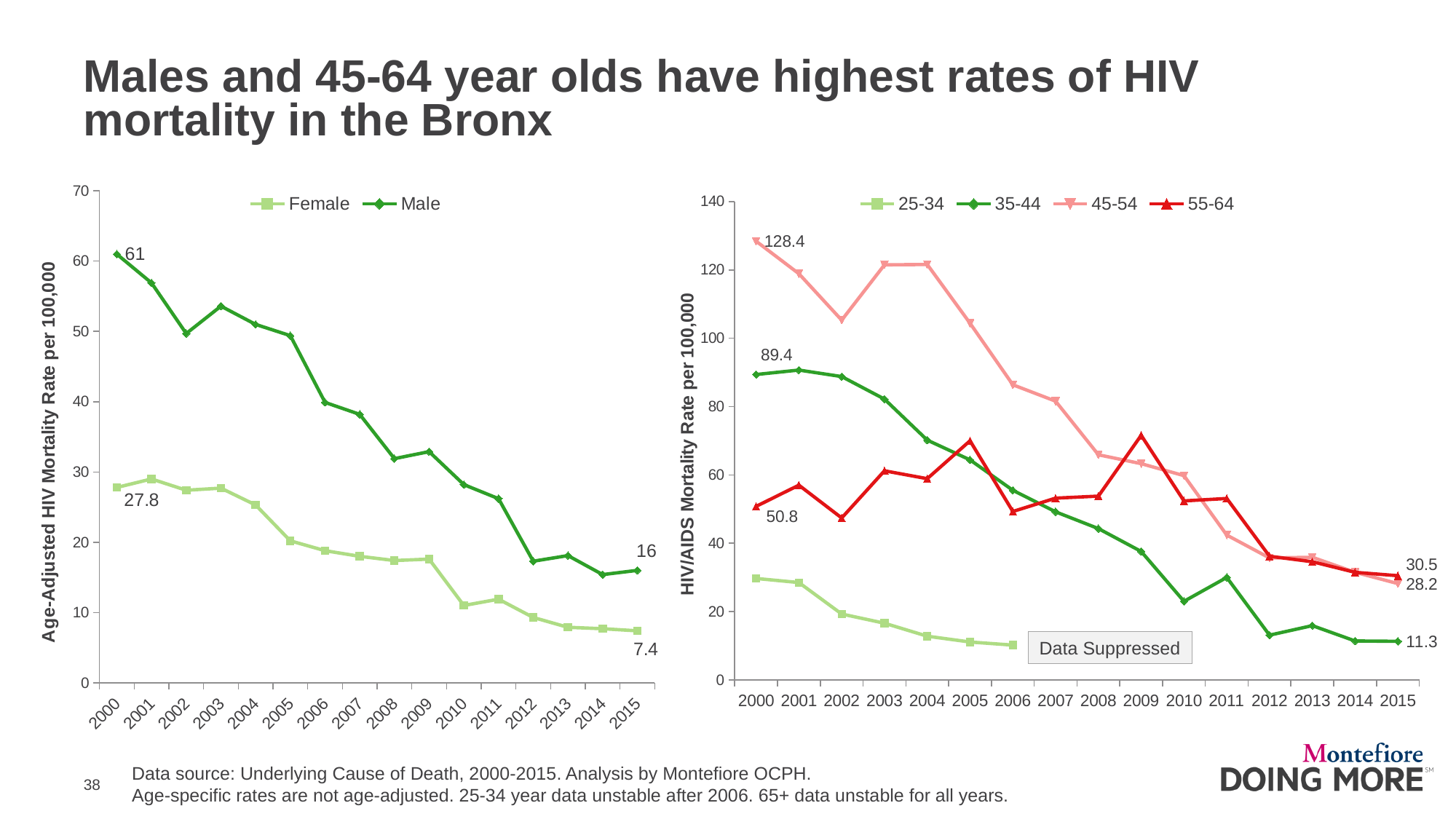
On the right chart, which age group has the highest rate in 2000? 45-54 On the right chart, which is larger in 2015, the 55-64 rate or the 45-54 rate? 55-64 What type of chart is the right chart? line chart On the left chart, what is the difference between the Male and Female rates in 2000? 33.2 On the left chart, what is the Female HIV mortality rate in 2015? 7.4 On the left chart, how many series does the legend list? 2 On the right chart, what is the difference between the 45-54 and 55-64 rates in 2000? 77.6 On the right chart, what is the 45-54 rate in 2000? 128.4 On the left chart, is the Male value for 2006 greater or less than 30? greater On the right chart, what is the 35-44 rate in 2015? 11.3 On the left chart, does the Male rate rise or fall from 2000 to 2015? fall On the left chart, what is the Male HIV mortality rate in 2000? 61